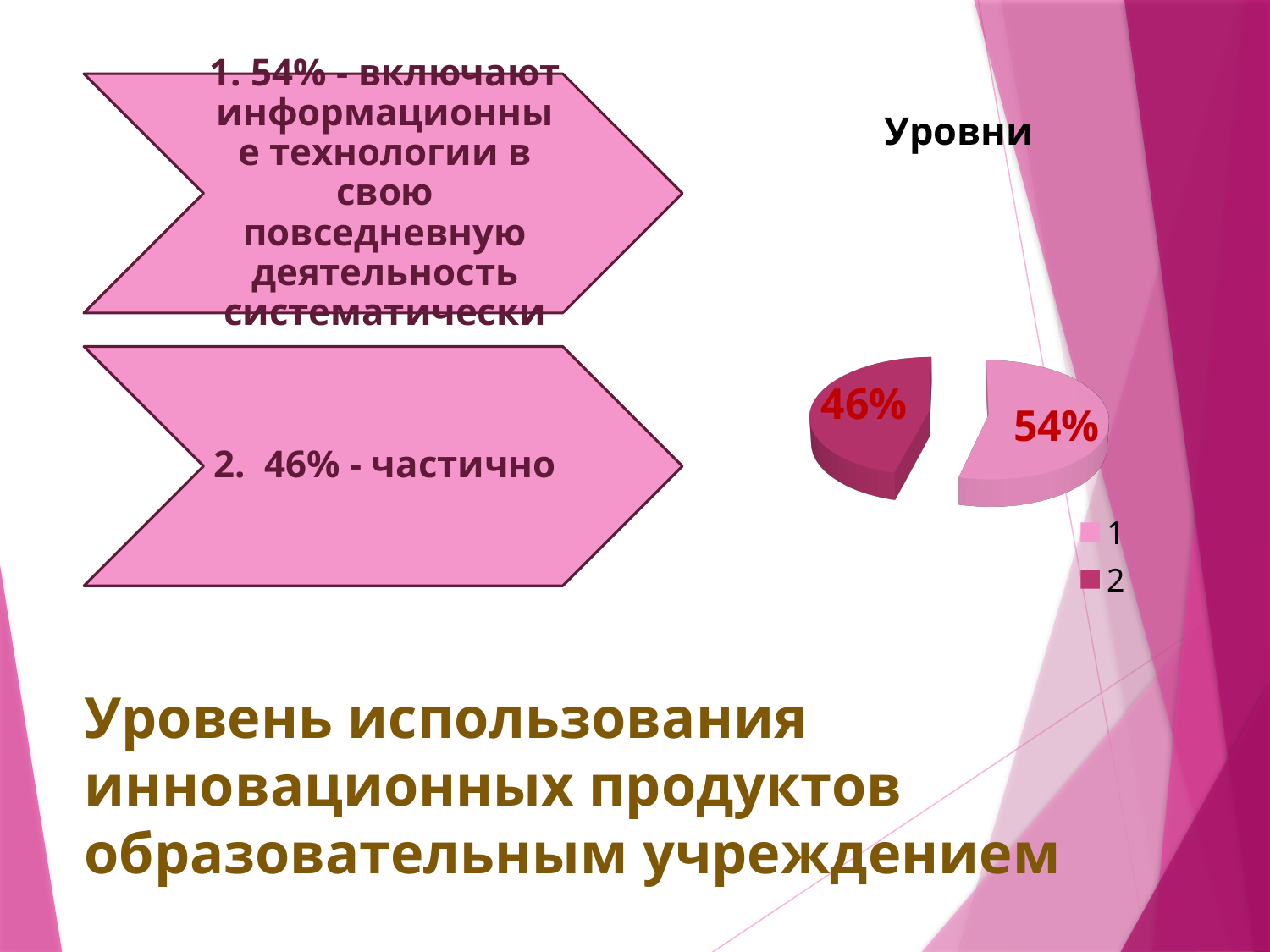
Is the share for slice 2 greater or less than 50%? less How many entries does the legend list? 2 Which slice is the smallest in the pie chart? 2 What kind of chart is shown on the slide? pie chart What share of the pie does slice 2 represent? 46% How many slices does the pie chart have? 2 What is the difference between the shares of slice 1 and slice 2? 8% What is the title of the chart? Уровни What is the total of the two slices shown in the pie chart? 100% Which is larger, slice 1 or slice 2? 1 What share of the pie does slice 1 represent? 54% Which slice is the largest in the pie chart? 1